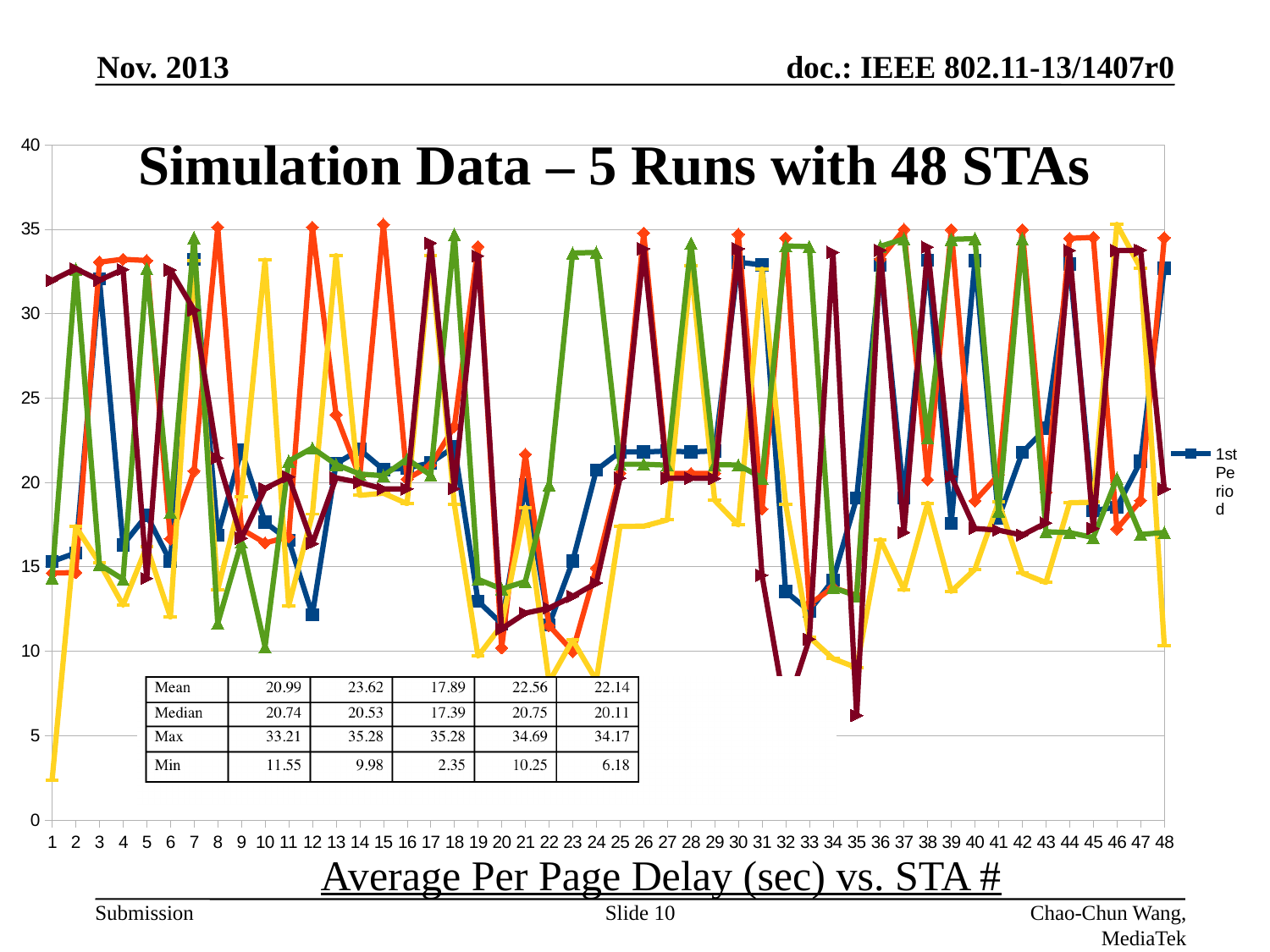
What is the title of the chart? Simulation Data – 5 Runs with 48 STAs Is the value of the blue '1st Period' line at STA 12 greater or less than 15? less How many STA categories are shown along the x axis? 48 At which STA does the yellow line reach its lowest value? 1 At which STA does the dark red line reach its lowest value? 35 What kind of chart is shown on the slide? line chart Is the value of the blue '1st Period' line at STA 48 greater or less than 30? greater How many lines (runs) are plotted on the chart? 5 Is the value of the orange line at STA 15 greater or less than 30? greater What is the highest value shown on the y axis? 40